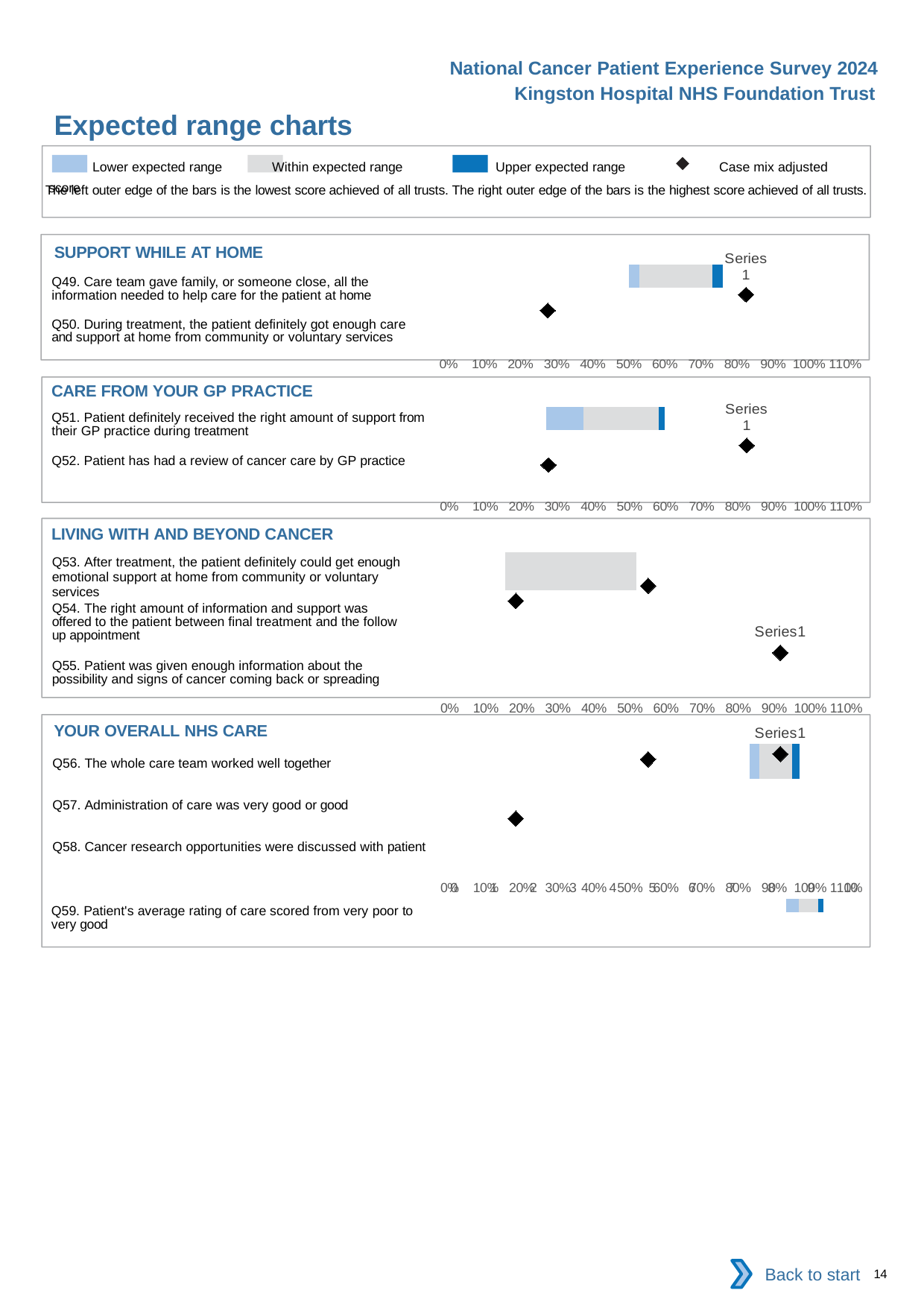
What kind of chart is used in the SUPPORT WHILE AT HOME section? Bar chart What is the highest tick label shown on the x axis of the CARE FROM YOUR GP PRACTICE chart? 110% In the YOUR OVERALL NHS CARE chart, is the case mix adjusted score diamond for Q56 greater or less than 40%? greater How many chart sections are shown on the slide? 4 How many questions are listed in the YOUR OVERALL NHS CARE section? 4 In the CARE FROM YOUR GP PRACTICE chart, is the case mix adjusted score diamond for Q52 greater or less than 50%? less How many questions are listed in the LIVING WITH AND BEYOND CANCER section? 3 Which legend entry is represented by the black diamond marker? Case mix adjusted score In the LIVING WITH AND BEYOND CANCER chart, is the right edge of the grey expected range bar greater or less than 70%? less